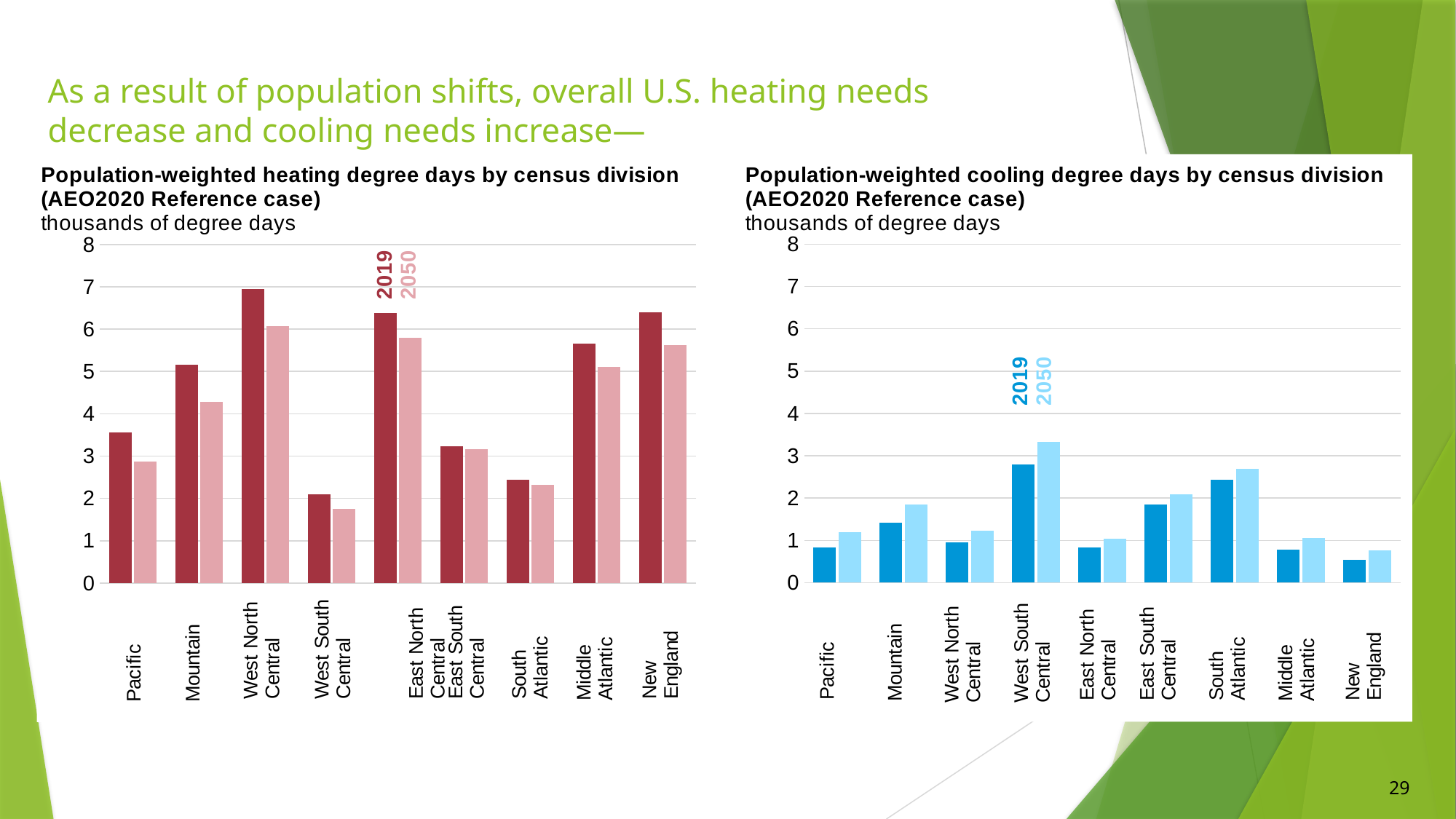
What unit is shown under the title of the cooling degree days chart? thousands of degree days In the cooling degree days chart, how many series are shown? 2 In the heating degree days chart, is the 2050 value for West South Central greater or less than 2? less In the heating degree days chart, which is larger for Mountain: the 2019 value or the 2050 value? 2019 In the cooling degree days chart, which census division has the highest 2050 value? West South Central In the heating degree days chart, which census division has the highest 2019 value? West North Central In the heating degree days chart, is the 2019 value for West North Central greater or less than 6? greater In the heating degree days chart, which census division has the lowest 2019 value? West South Central In the cooling degree days chart, is the 2050 value for West South Central greater or less than 3? greater In the cooling degree days chart, which census division has the lowest 2019 value? New England What kind of chart is the 'Population-weighted heating degree days by census division' chart? bar chart In the heating degree days chart, how many census divisions are shown on the x axis? 9